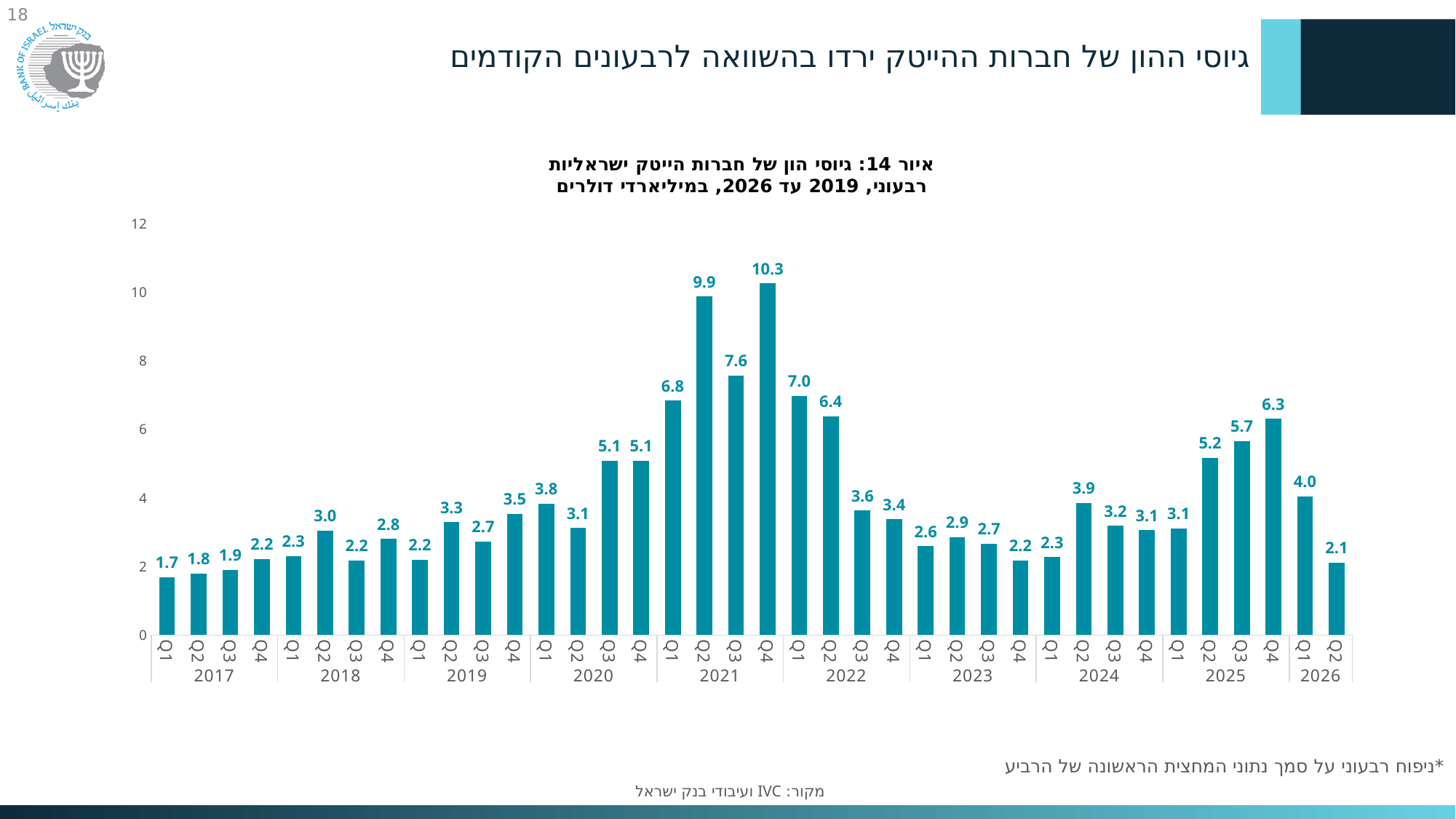
Which quarter has the highest value? Q4 2021 What is the difference between the values for Q1 2026 and Q2 2026? 1.9 Do the values rise or fall from Q4 2025 to Q2 2026? Fall Which is larger, the value for Q3 2025 or the value for Q1 2022? Q1 2022 Is the value for Q1 2021 greater or less than 6? greater What is the value for Q2 2026? 2.1 Which quarter has the lowest value? Q1 2017 What kind of chart is shown on the slide? Bar chart What is the value for Q4 2021? 10.3 How many bars are plotted in the chart? 38 What is the value for Q4 2025? 6.3 What is the difference between the values for Q2 2021 and Q4 2021? 0.4